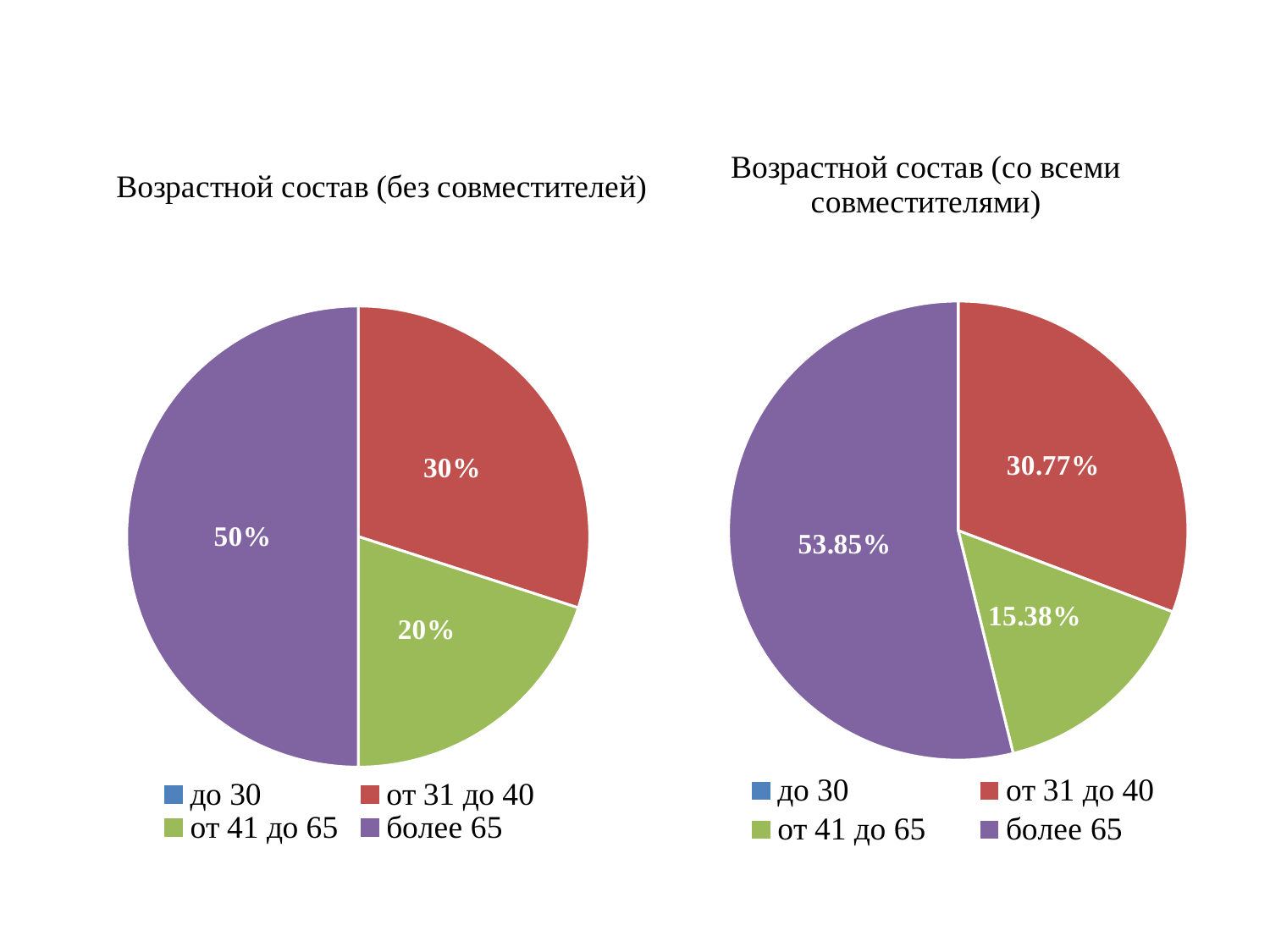
In the chart titled "Возрастной состав (без совместителей)", what share is labelled for the "более 65" slice? 50% In the chart titled "Возрастной состав (без совместителей)", what share is labelled for the "от 31 до 40" slice? 30% What type of chart is the left chart on the slide? Pie chart How many entries does the legend of the chart titled "Возрастной состав (без совместителей)" list? 4 In the chart titled "Возрастной состав (со всеми совместителями)", which is larger: the "от 31 до 40" slice or the "от 41 до 65" slice? от 31 до 40 In the chart titled "Возрастной состав (без совместителей)", what share is labelled for the "от 41 до 65" slice? 20% In the chart titled "Возрастной состав (со всеми совместителями)", which labelled slice is the smallest? от 41 до 65 In the chart titled "Возрастной состав (без совместителей)", which category has the largest slice? более 65 In the chart titled "Возрастной состав (со всеми совместителями)", what share is labelled for the "более 65" slice? 53.85% In the chart titled "Возрастной состав (со всеми совместителями)", what share is labelled for the "от 31 до 40" slice? 30.77% In the chart titled "Возрастной состав (без совместителей)", what is the difference between the "более 65" share and the "от 41 до 65" share? 30% In the chart titled "Возрастной состав (со всеми совместителями)", what share is labelled for the "от 41 до 65" slice? 15.38%